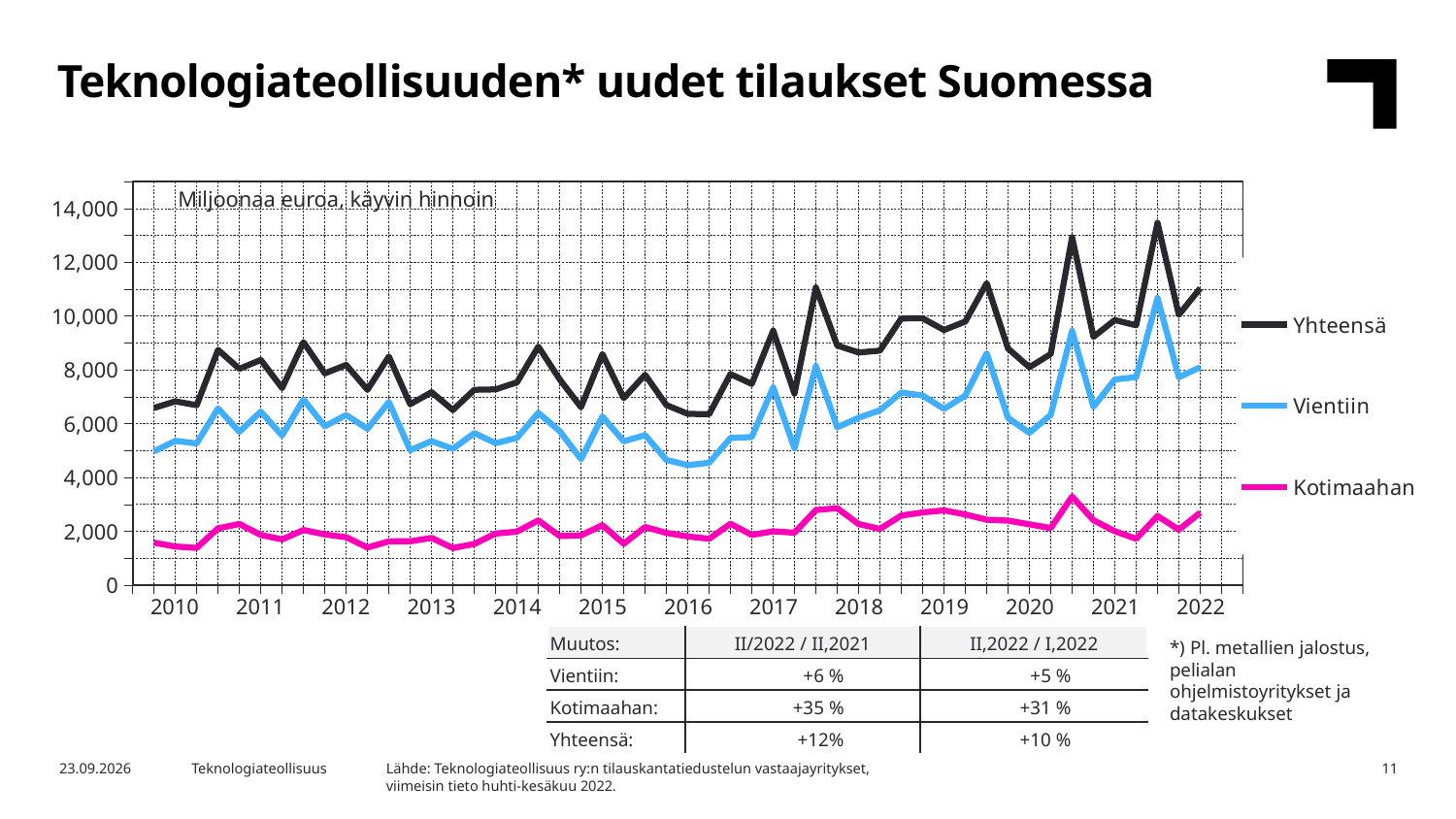
Is the peak value for Yhteensä in 2021 greater or less than 12,000? greater Does the Yhteensä series rise or fall overall from 2010 to 2022? rise What kind of chart is shown on the slide? line chart How many years are labelled on the x axis? 13 Which series has the highest values throughout the chart? Yhteensä Is the value for Kotimaahan in 2010 greater or less than 4,000? less Is the value for Yhteensä at the start of 2010 greater or less than 6,000? greater How many series does the chart legend list? 3 What unit label is printed inside the chart area? Miljoonaa euroa, käyvin hinnoin Which series has the lowest values throughout the chart? Kotimaahan Which is larger in 2022, the value for Vientiin or the value for Kotimaahan? Vientiin